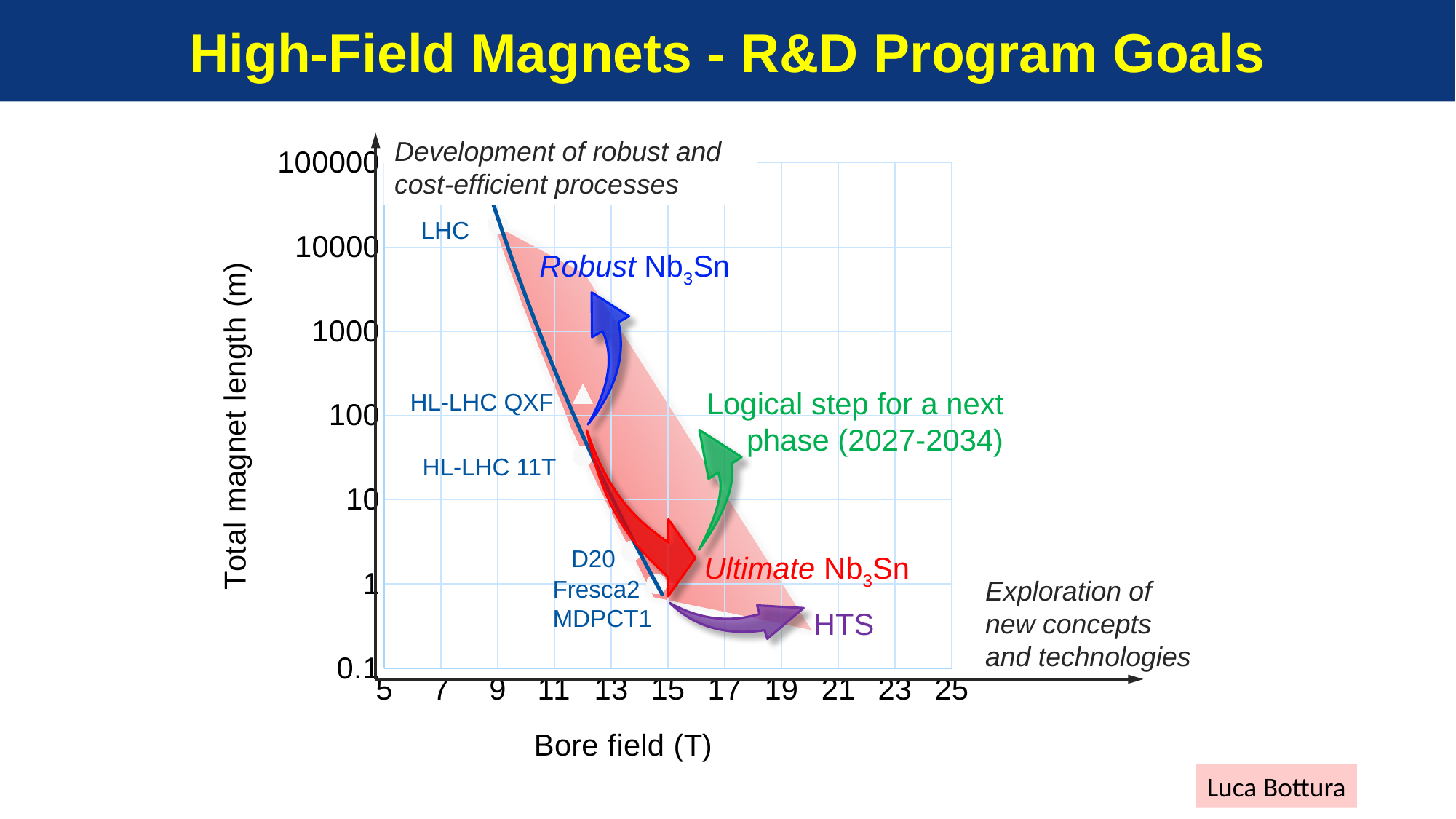
Which has the larger bore field, LHC or D20? D20 Is the total magnet length for LHC greater or less than 1000? greater As bore field increases along the x axis, does total magnet length rise or fall? fall What is the title of the y axis? Total magnet length (m) Which labeled magnet has the highest total magnet length? LHC Is the bore field for HL-LHC QXF greater or less than 11? greater Is the total magnet length for D20 greater or less than 10? less What is the title of the x axis? Bore field (T) Which has the larger total magnet length, LHC or HL-LHC 11T? LHC Which labeled magnet has the lowest bore field? LHC What kind of chart is shown on the slide? scatter chart